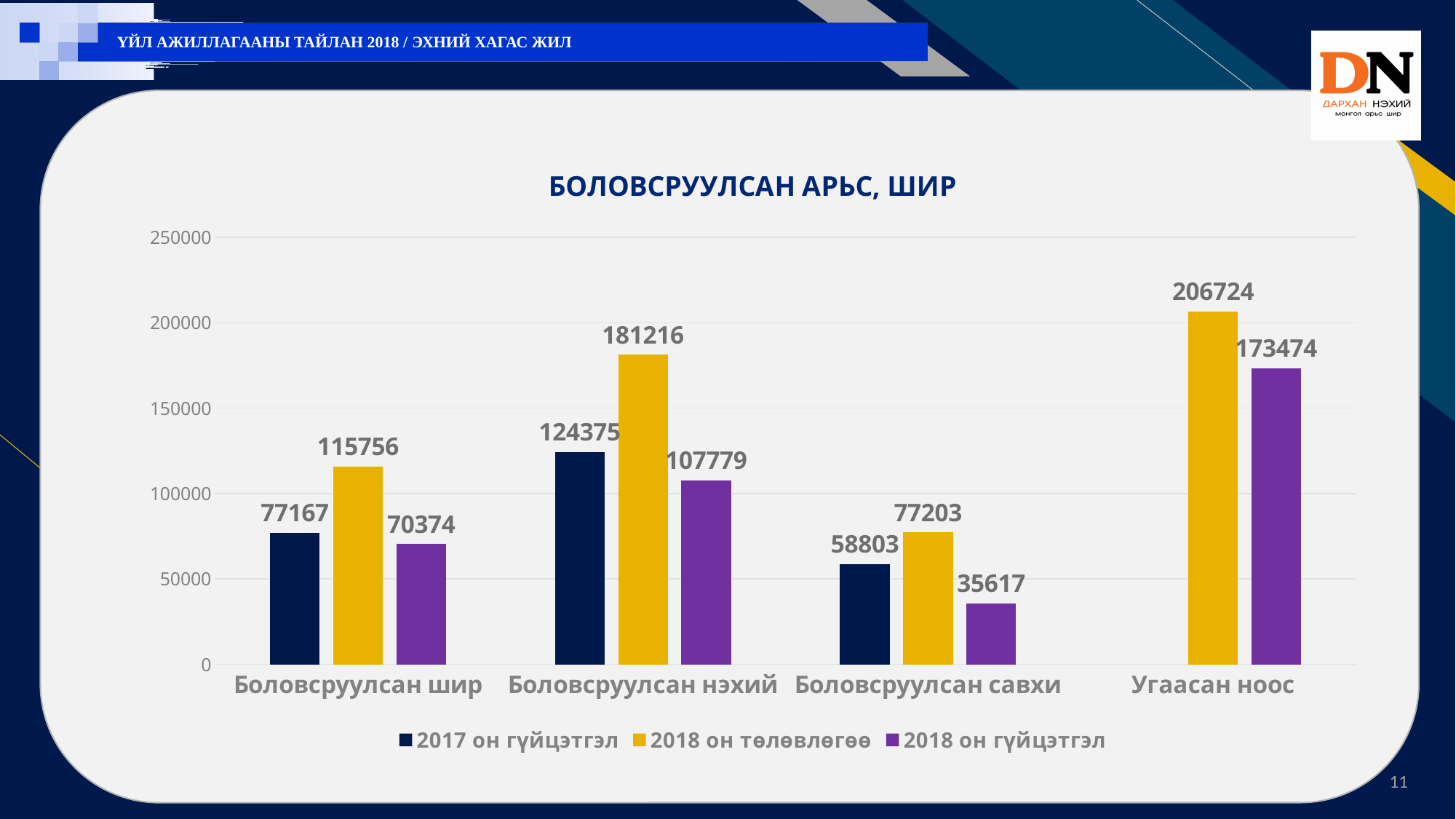
How many series does the legend list? 3 What is the title of the chart? БОЛОВСРУУЛСАН АРЬС, ШИР What is the value of 2018 он гүйцэтгэл for Угаасан ноос? 173474 Which category has the highest 2018 он төлөвлөгөө value? Угаасан ноос What kind of chart is shown on the slide? bar chart Is the 2018 он төлөвлөгөө value for Угаасан ноос greater or less than 200000? greater What is the value of 2017 он гүйцэтгэл for Боловсруулсан савхи? 58803 What is the difference between 2018 он төлөвлөгөө and 2018 он гүйцэтгэл for Боловсруулсан шир? 45382 How many categories are shown on the x axis? 4 What is the value of 2018 он төлөвлөгөө for Боловсруулсан нэхий? 181216 Which is larger for Боловсруулсан нэхий: 2017 он гүйцэтгэл or 2018 он гүйцэтгэл? 2017 он гүйцэтгэл Which category has the lowest 2018 он гүйцэтгэл value? Боловсруулсан савхи